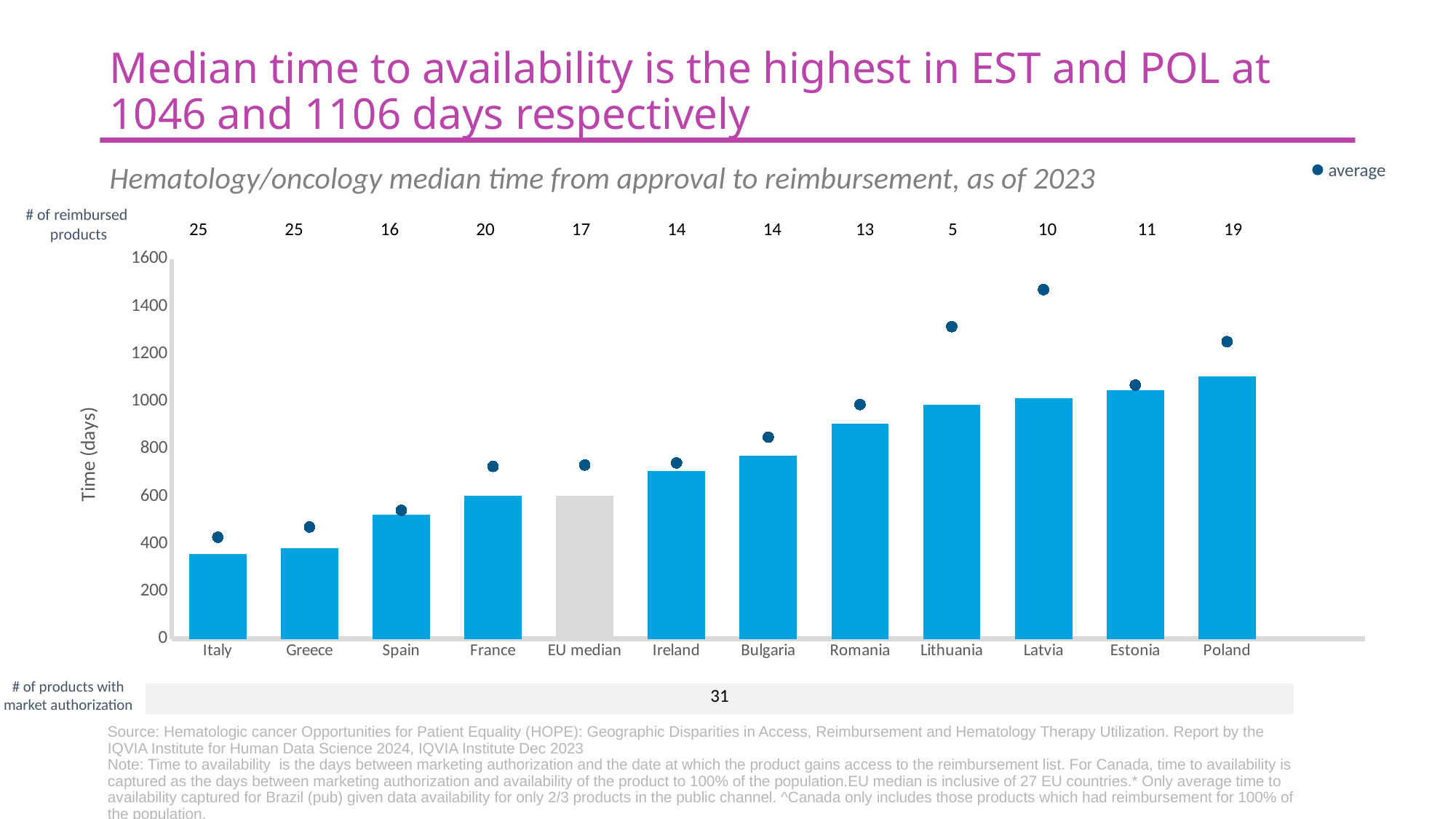
How many categories are shown along the x axis of the chart? 12 Is the median time value for Italy greater or less than 400 days? less According to the slide, what is the median time to availability in Poland in days? 1106 days Do the median time bars generally rise or fall from left to right along the x axis? rise How many reimbursed products are listed for Lithuania above the chart? 5 Which category has the highest median time from approval to reimbursement? Poland Is the median time value for Romania greater or less than 1000 days? less Which category has the lowest median time from approval to reimbursement? Italy What kind of chart is shown on the slide? bar chart Is the median time value for Ireland greater or less than 600 days? greater According to the slide, what is the median time to availability in Estonia in days? 1046 days Which has a larger median time bar, Ireland or Bulgaria? Bulgaria